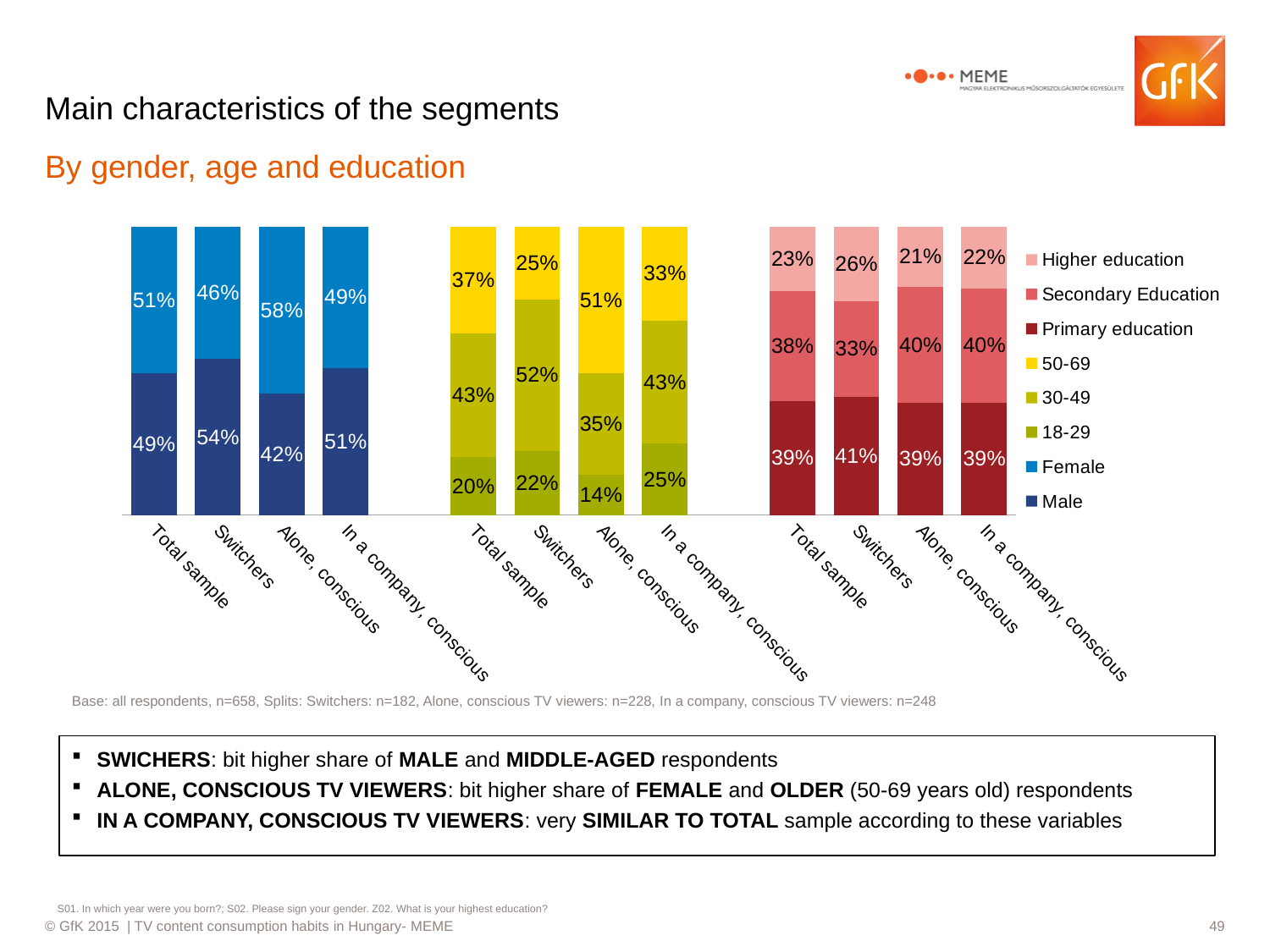
What is the difference between the Male share in Switchers and the Male share in the Total sample? 5% What is the total of the Primary, Secondary and Higher education shares for the Total sample? 100% What is the 50-69 age share for the Alone, conscious segment? 51% What is the Higher education share for the Switchers segment? 26% Which is larger: the 30-49 share for Switchers or the 30-49 share for the Total sample? Switchers What is the share of Male respondents in the Switchers segment? 54% What type of chart is shown on the slide? Stacked bar chart What is the share of Female respondents among Alone, conscious viewers? 58% What colour represents the Female series in the chart? Blue Which segment has the lowest share of 18-29 year olds? Alone, conscious Which segment has the highest share of 18-29 year olds? In a company, conscious How many entries does the legend list? 8